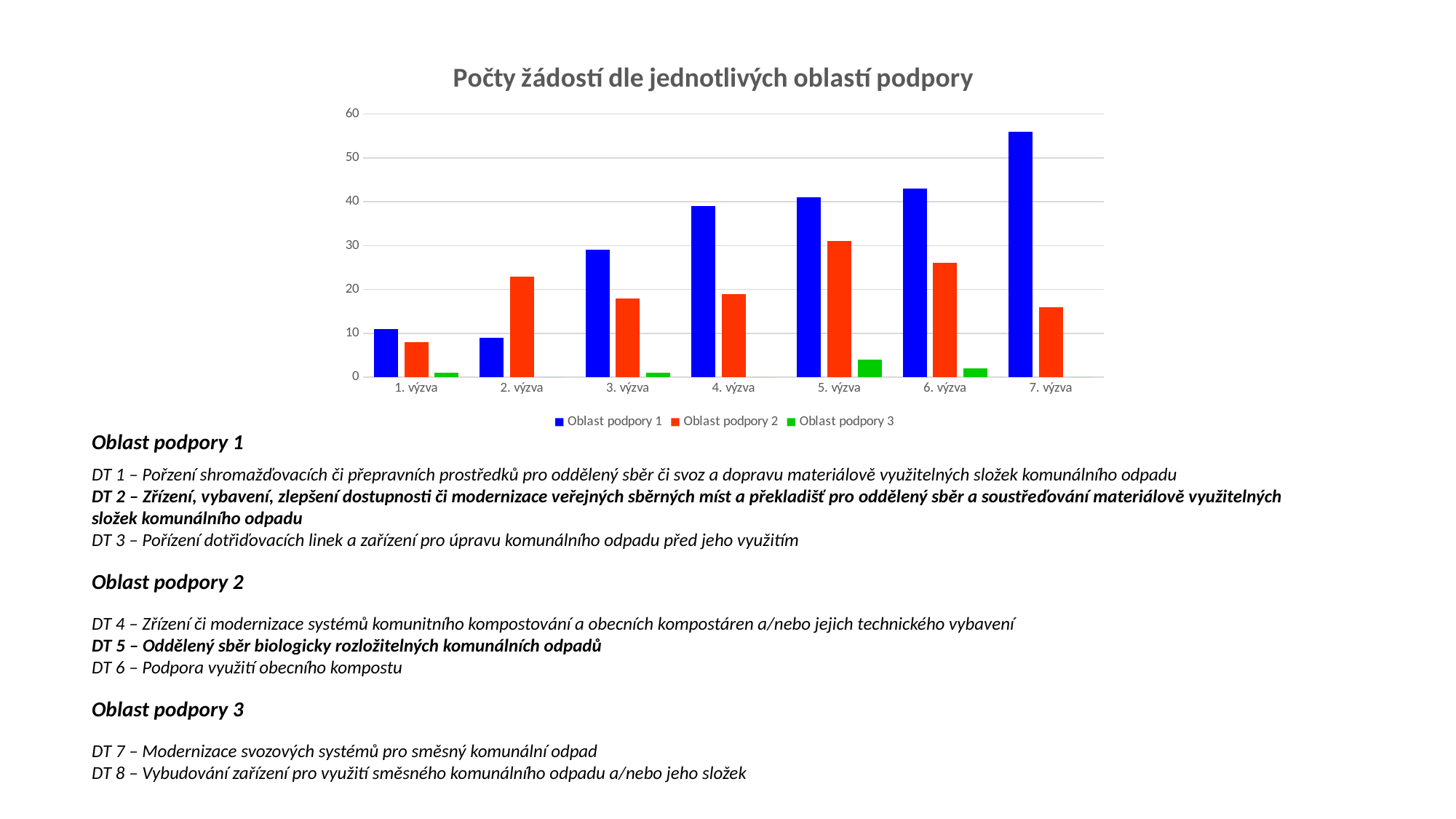
In which výzva is the value for Oblast podpory 2 highest? 5. výzva In which výzva is the value for Oblast podpory 2 lowest? 1. výzva In which výzva is the value for Oblast podpory 1 highest? 7. výzva In which výzva is the value for Oblast podpory 3 highest? 5. výzva Is the value for Oblast podpory 1 in 7. výzva greater or less than 50? greater What is the title of the chart? Počty žádostí dle jednotlivých oblastí podpory Does the value for Oblast podpory 1 rise or fall from 2. výzva to 7. výzva? rise In 2. výzva, which is larger: Oblast podpory 1 or Oblast podpory 2? Oblast podpory 2 What kind of chart is shown on the slide? bar chart How many series does the legend list? 3 How many categories (výzvy) are shown on the x axis? 7 Is the value for Oblast podpory 2 in 6. výzva greater or less than 20? greater